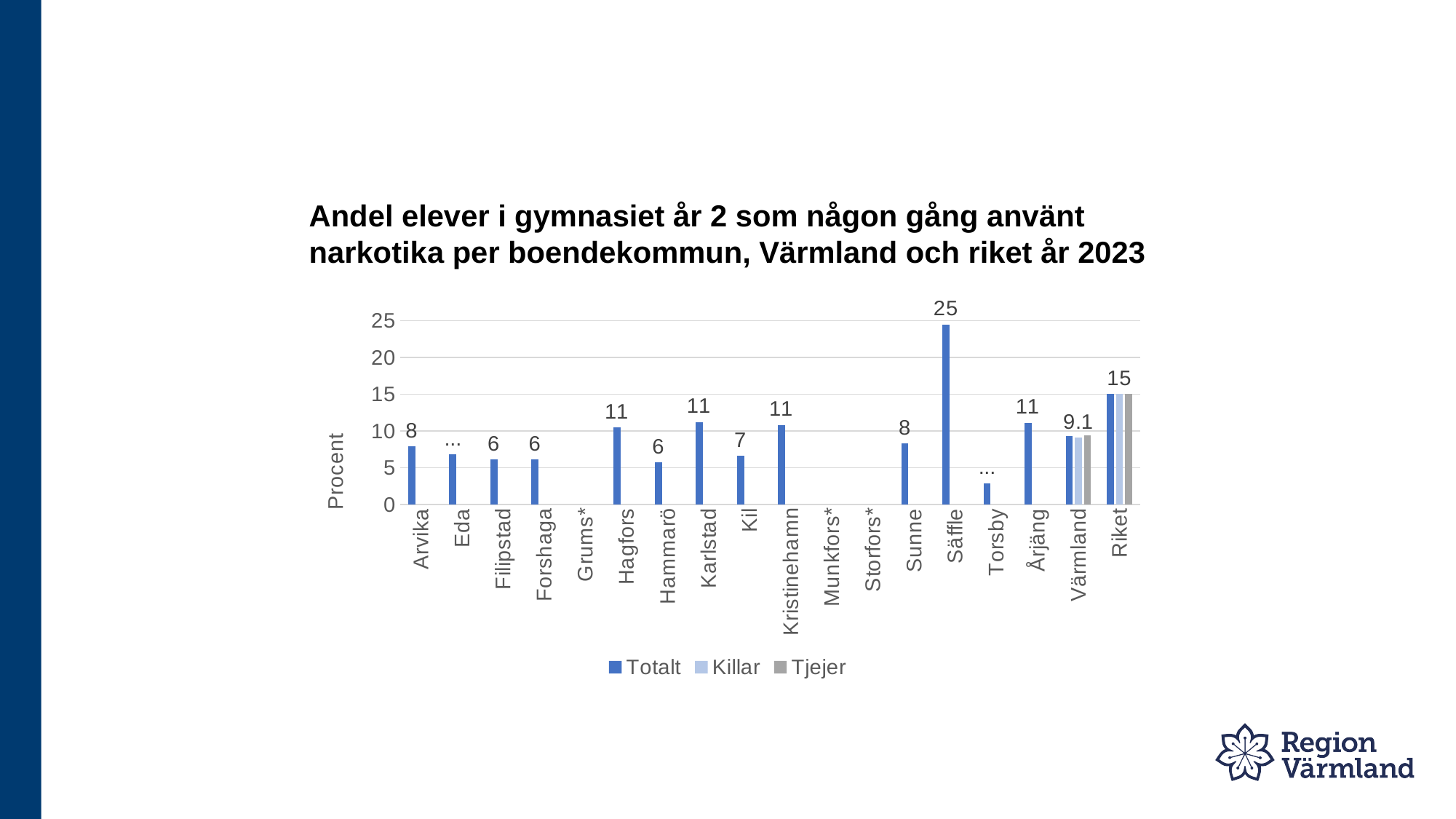
Which municipality has the highest value? Säffle Is the value for Torsby greater or less than 5? less What is the value for Säffle? 25 What is the value for Värmland? 9.1 What is the difference between the values for Säffle and Riket? 10 What is the value for Riket? 15 What is the label on the y axis? Procent How many series does the legend list? 3 What is the value for Hagfors? 11 How many categories are shown on the x axis? 18 Which is larger, the value for Arvika or the value for Kil? Arvika What kind of chart is shown on the slide? Bar chart